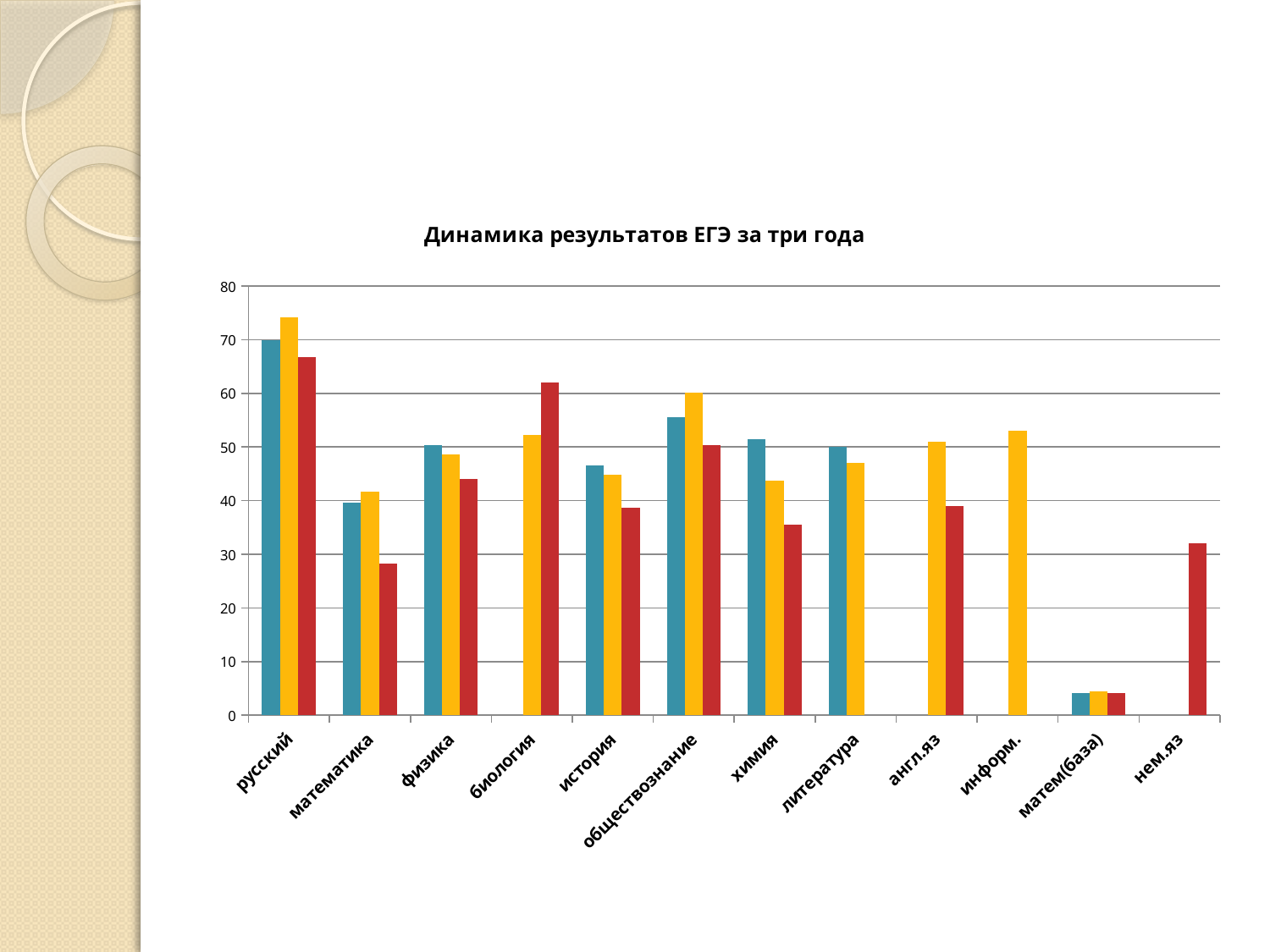
What kind of chart is shown on the slide? bar chart For русский, which is taller: the blue bar or the yellow bar? yellow Which category has the lowest bars overall? матем(база) What is the title of the chart? Динамика результатов ЕГЭ за три года How many differently coloured bar series are plotted in the chart? 3 Is the red bar for математика greater or less than 30? less Is the yellow bar for обществознание greater or less than 50? greater Which category has the tallest yellow bar? русский How many subject categories are shown on the x axis? 12 Is the red bar for нем.яз greater or less than 40? less For химия, which is taller: the blue bar or the red bar? blue